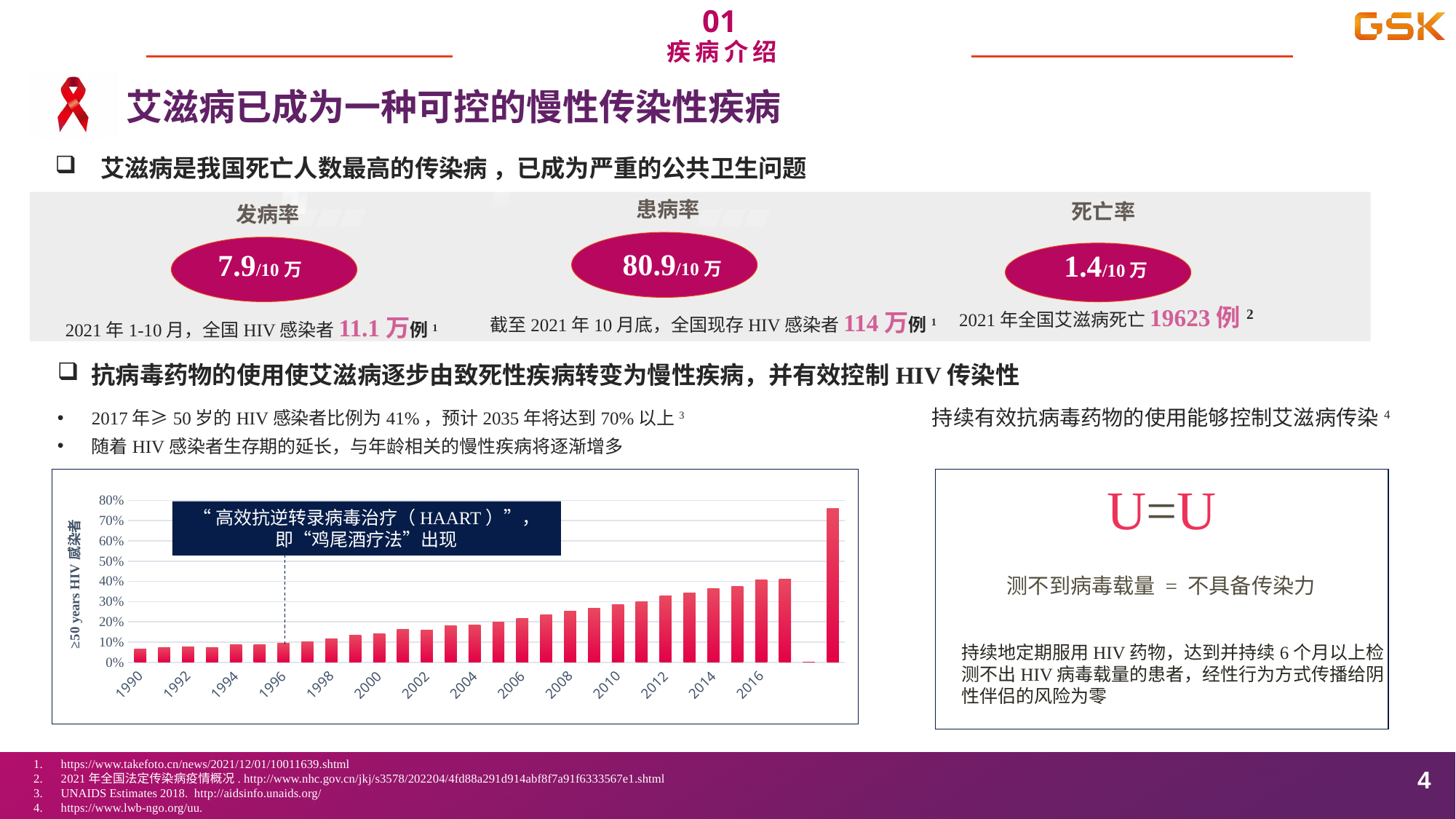
What is the label on the y axis of the bar chart? ≥50 years HIV 感染者 In the bar chart, is the value for 1990 greater or less than 10%? less In the bar chart, is the value for 2000 greater or less than 10%? greater In the bar chart, do the values generally rise or fall from 1990 to 2016? rise How many year labels are shown on the x axis of the bar chart? 14 In the bar chart, is the value for 2008 greater or less than 20%? greater In the bar chart, which is larger, the value for 2010 or the value for 2000? 2010 What kind of chart is shown at the bottom left of the slide? bar chart In the bar chart, which labelled year has the lowest value? 1990